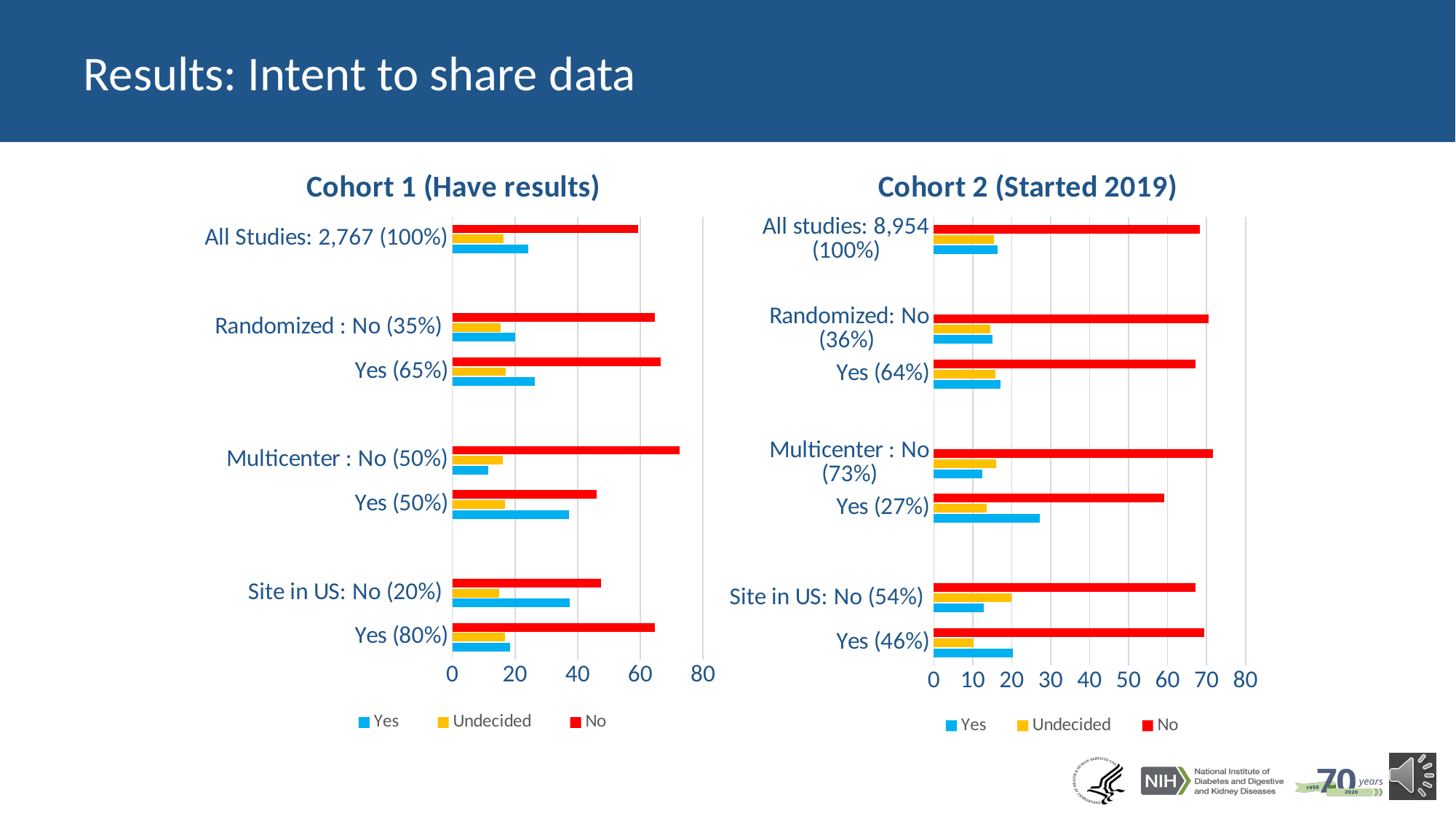
In the Cohort 2 (Started 2019) chart, which category has the longest Yes bar? Multicenter Yes (27%) In the Cohort 1 (Have results) chart, which has the larger No value: Multicenter : No (50%) or Multicenter Yes (50%)? Multicenter : No (50%) In the Cohort 2 (Started 2019) chart, is the No value for Multicenter : No (73%) greater or less than 60? greater In the Cohort 2 (Started 2019) chart, is the Yes value for Multicenter Yes (27%) greater or less than 20? greater What kind of chart is the Cohort 1 (Have results) chart? bar chart In the Cohort 1 (Have results) chart, is the No value for Multicenter : No (50%) greater or less than 60? greater In the Cohort 2 (Started 2019) chart, which has the larger Yes value: Multicenter : No (73%) or Multicenter Yes (27%)? Multicenter Yes (27%) What is the title of the chart on the right side of the slide? Cohort 2 (Started 2019) What colour represents the No series in both charts? red How many series does the legend of the Cohort 2 (Started 2019) chart list? 3 How many categories are plotted on the Cohort 1 (Have results) chart? 7